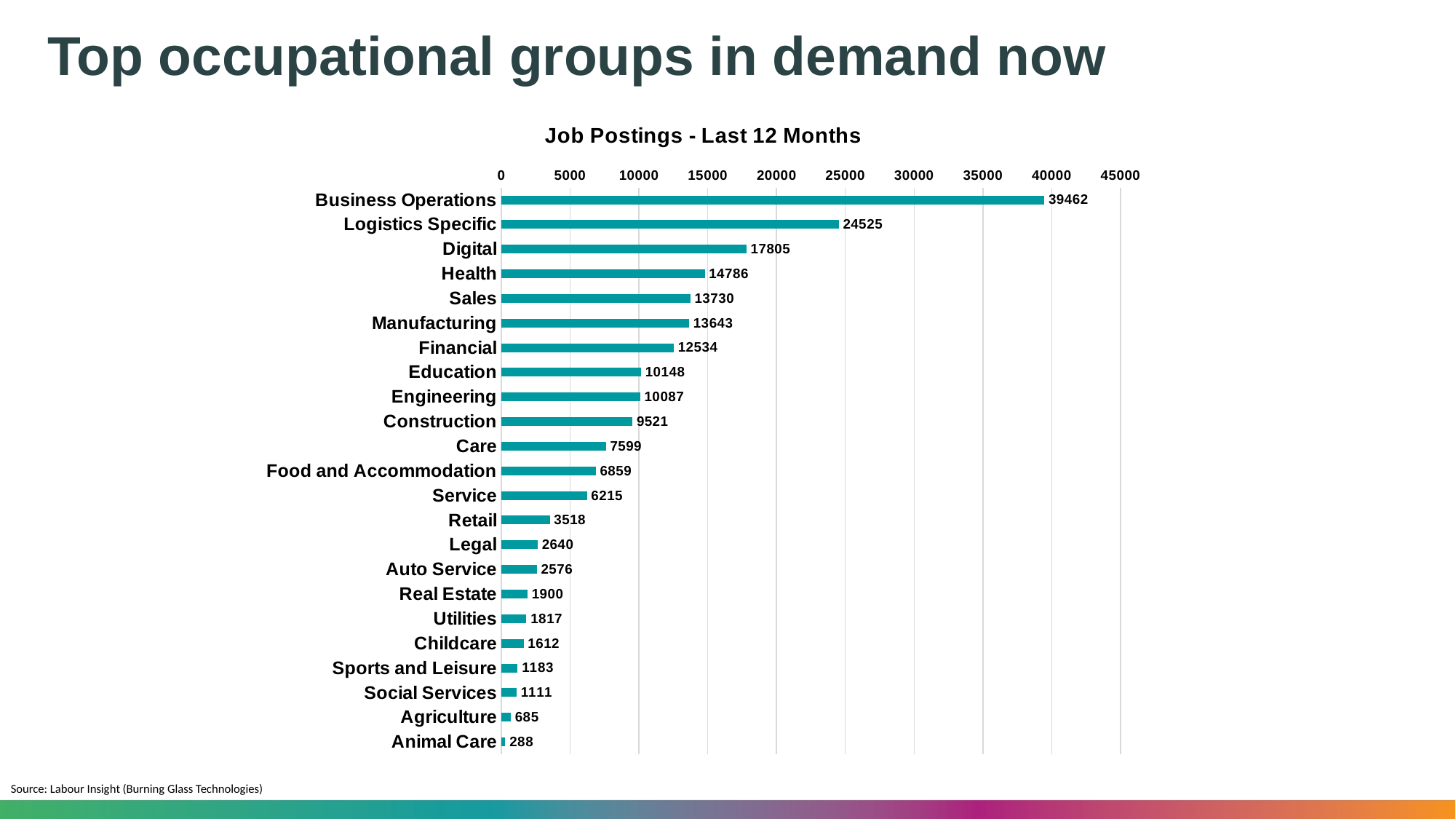
Which has more job postings, Care or Service? Care Which occupational group has the lowest number of job postings? Animal Care What kind of chart is shown on the slide? Bar chart How many occupational groups are shown in the chart? 23 What is the title of the chart? Job Postings - Last 12 Months What is the difference in job postings between Digital and Health? 3019 What is the number of job postings for Real Estate? 1900 What is the difference in job postings between Business Operations and Logistics Specific? 14937 What is the number of job postings for Construction? 9521 Is the value for Logistics Specific greater or less than 25000? less What is the number of job postings for Business Operations? 39462 Which occupational group has the highest number of job postings? Business Operations